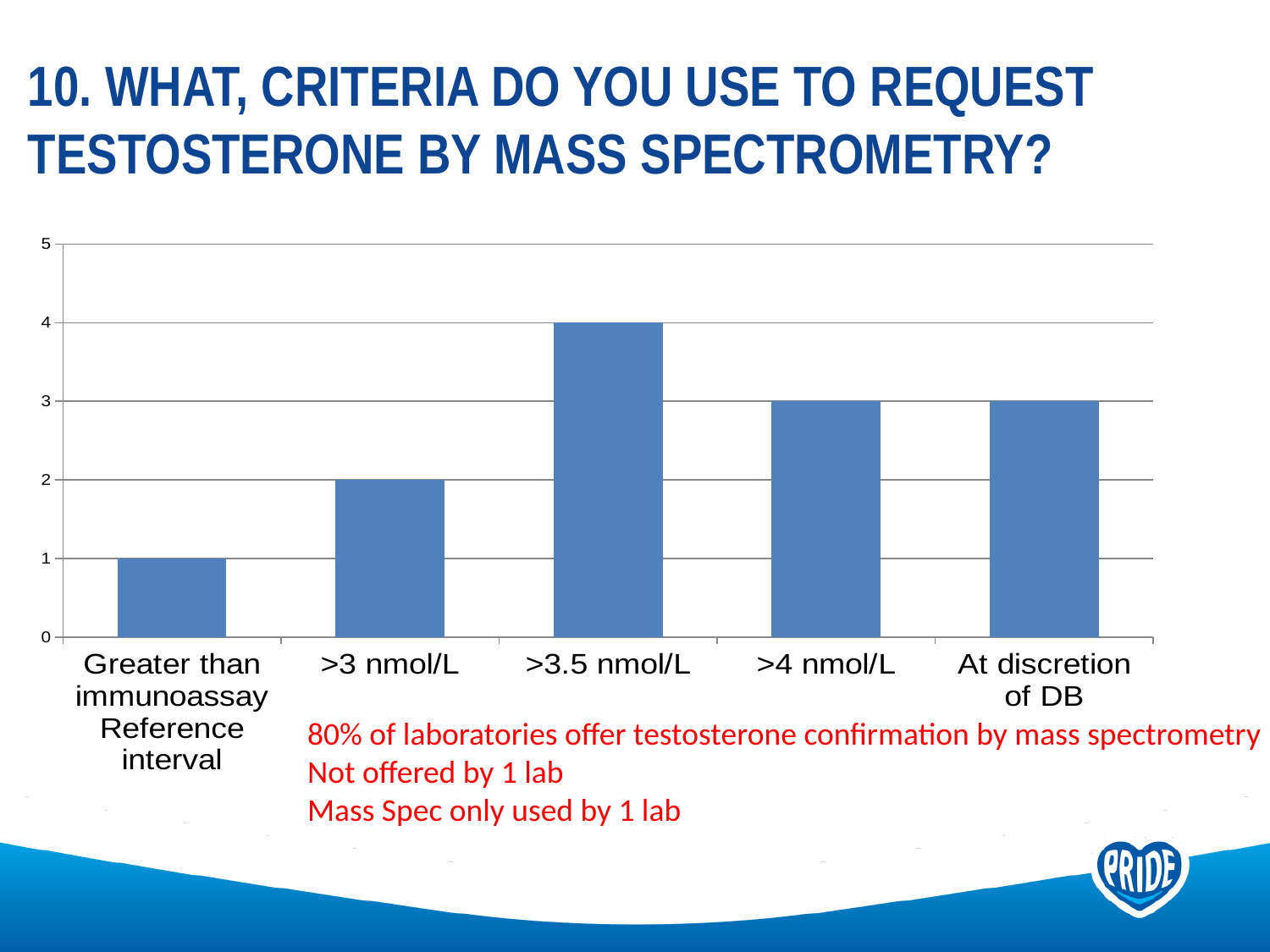
What is the value for ">3 nmol/L"? 2 Which is larger, the value for ">4 nmol/L" or the value for ">3 nmol/L"? >4 nmol/L Which category has the lowest value? Greater than immunoassay Reference interval How many categories are shown on the x axis of the chart? 5 What is the value for ">3.5 nmol/L"? 4 What is the value for "At discretion of DB"? 3 What is the difference between the values for ">3.5 nmol/L" and ">3 nmol/L"? 2 What kind of chart is shown on the slide? bar chart Which category has the highest value? >3.5 nmol/L What is the maximum value shown on the vertical axis of the chart? 5 What is the value for "Greater than immunoassay Reference interval"? 1 Is the value for ">3.5 nmol/L" greater or less than 3? greater